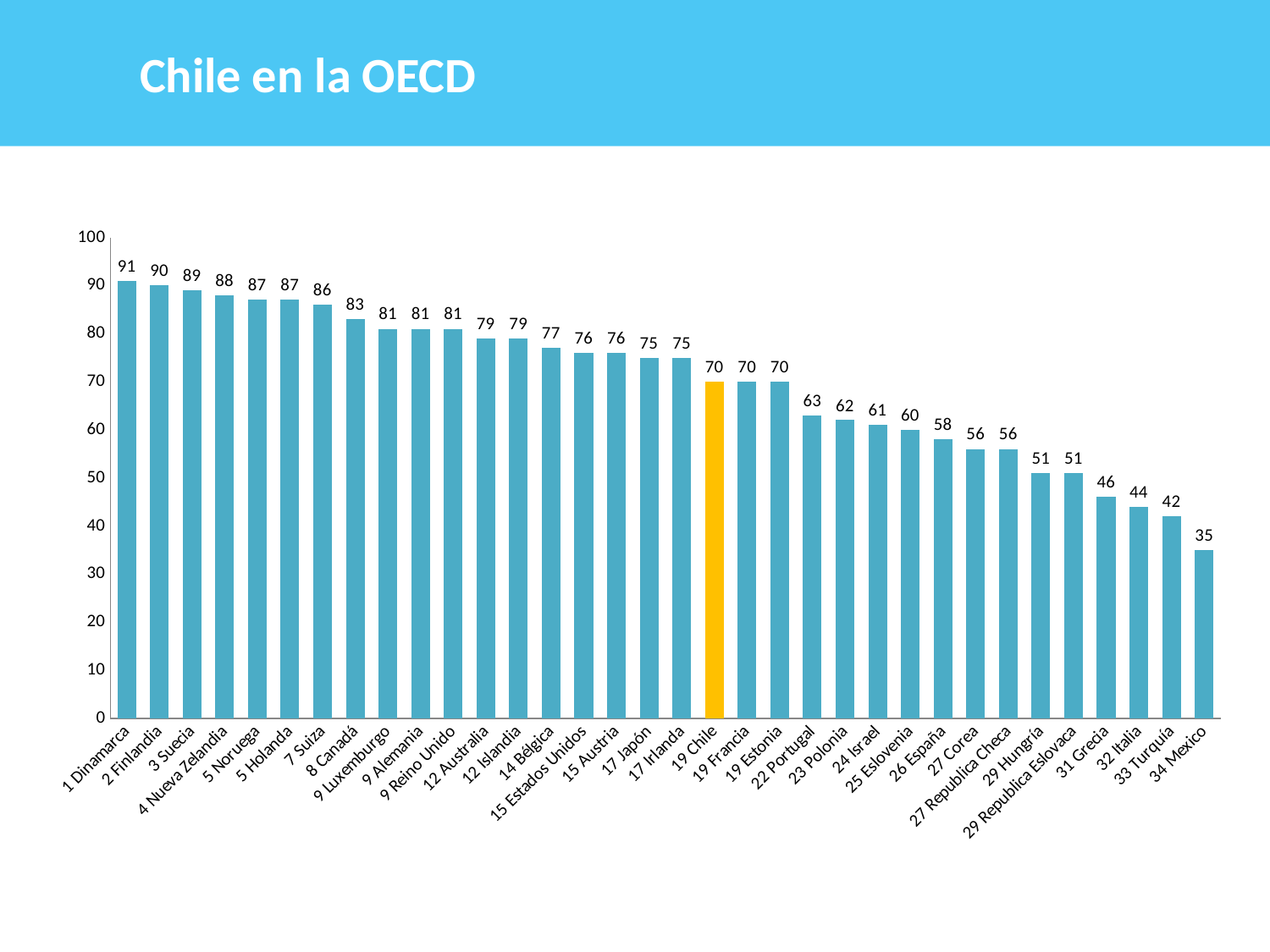
What kind of chart is shown on the slide? bar chart What is the value for 34 Mexico? 35 Which category has the highest value? 1 Dinamarca What is the difference between the values for 1 Dinamarca and 19 Chile? 21 Which category has the lowest value? 34 Mexico Which is larger, the value for 14 Bélgica or the value for 24 Israel? 14 Bélgica What is the difference between the values for 22 Portugal and 31 Grecia? 17 Which bar is highlighted in a different colour (yellow) from the others? 19 Chile What is the value for 19 Chile? 70 Do the values rise or fall from left to right along the x axis? fall How many bars are shown in the chart? 34 What is the value for 8 Canadá? 83